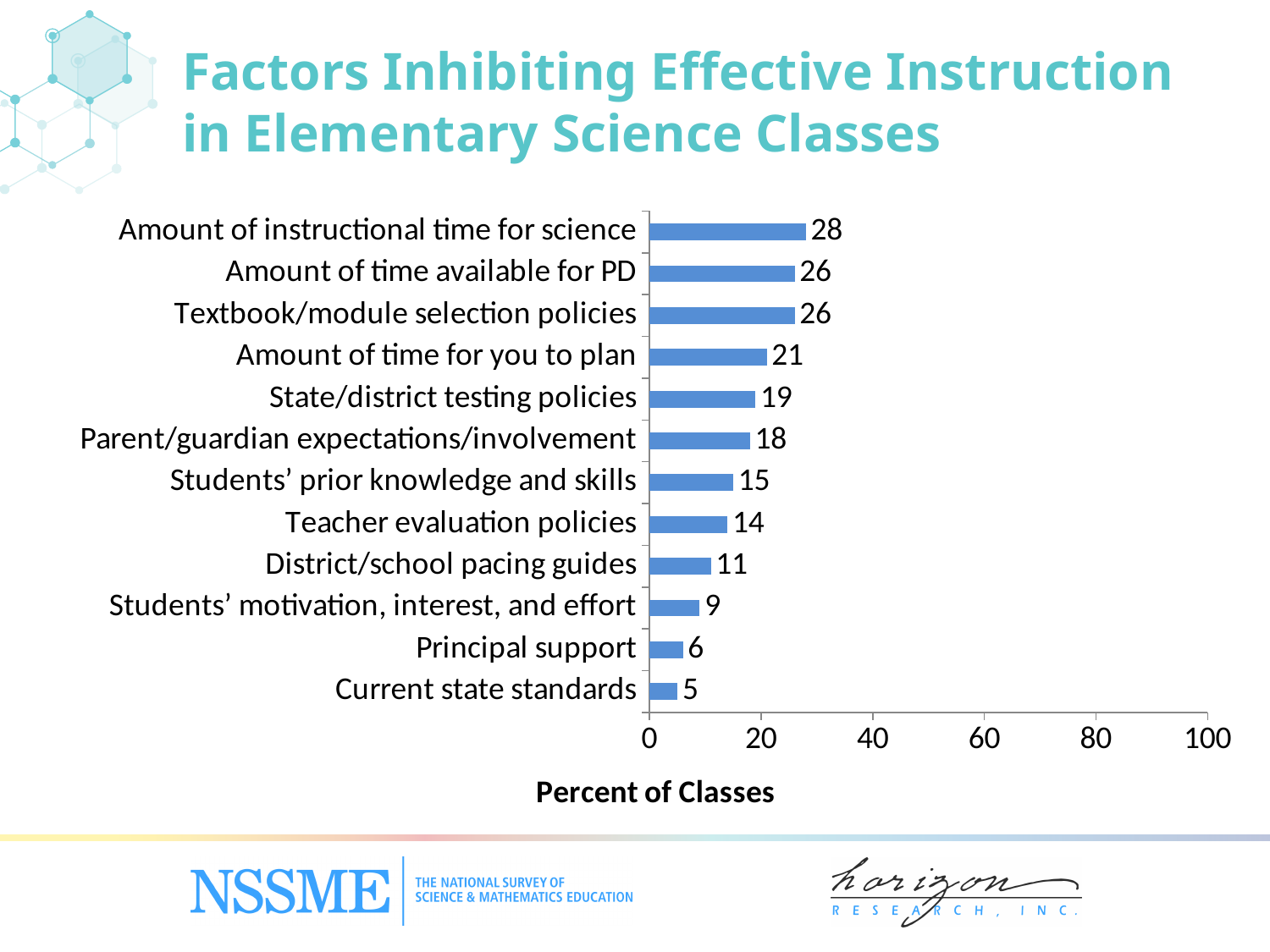
Which factor has the lowest value? Current state standards What is the value for State/district testing policies? 19 What is the difference between the values for Amount of time for you to plan and Teacher evaluation policies? 7 What is the value for Principal support? 6 Is the value for Textbook/module selection policies greater or less than 20? greater Which is larger, the value for Parent/guardian expectations/involvement or the value for District/school pacing guides? Parent/guardian expectations/involvement How many factors are shown in the chart? 12 What is the title of the slide? Factors Inhibiting Effective Instruction in Elementary Science Classes Which factor has the highest value? Amount of instructional time for science What kind of chart is shown on the slide? bar chart What is the label of the horizontal axis? Percent of Classes What is the value for Amount of instructional time for science? 28